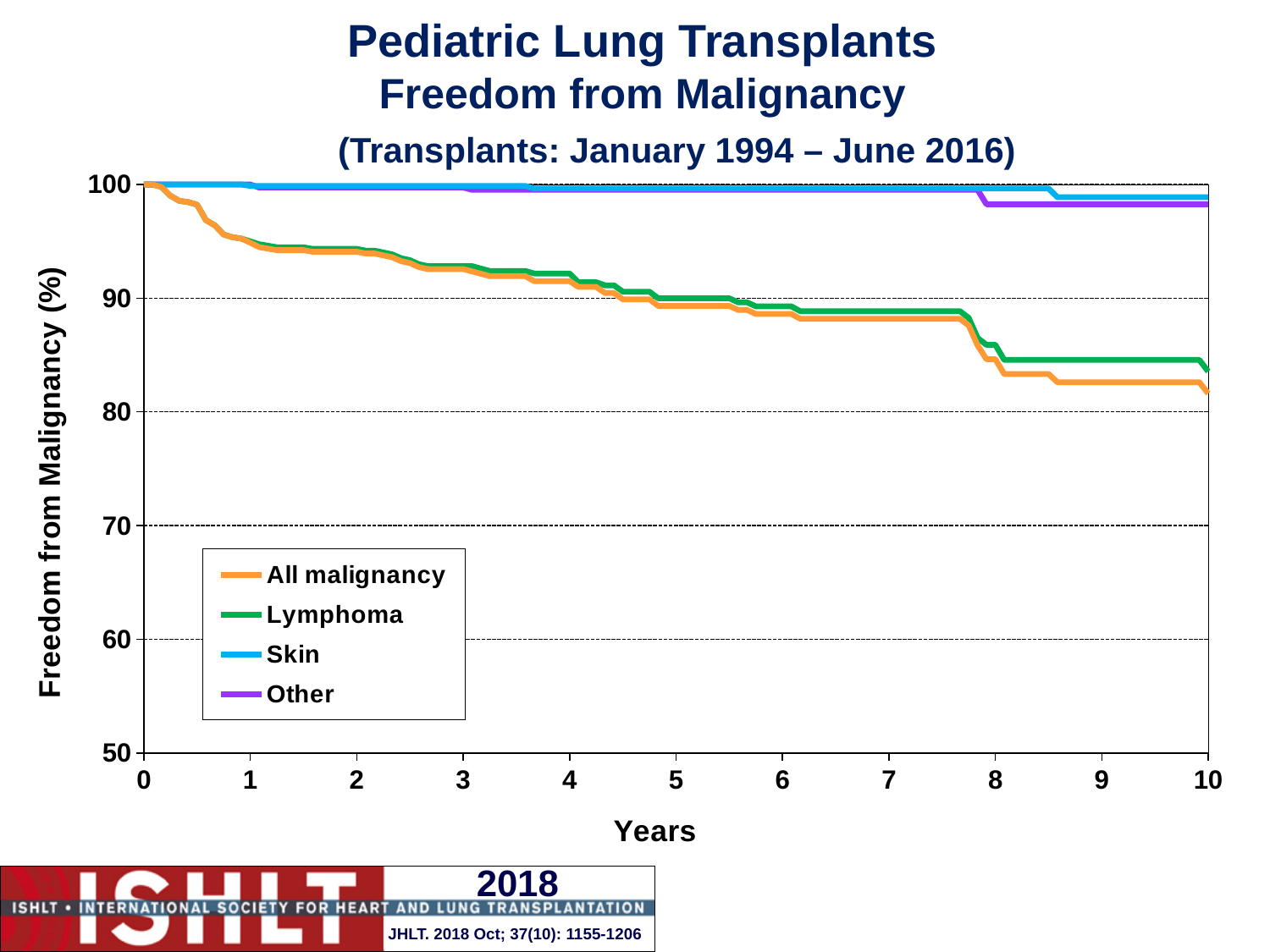
Is the value for All malignancy at 10 years greater or less than 80? greater What colour is the line for Skin? Light blue Is the value for Lymphoma at 2 years greater or less than 90? greater At 10 years, which is higher: Lymphoma or All malignancy? Lymphoma What kind of chart is shown on the slide? Line chart What is the label of the y axis? Freedom from Malignancy (%) Which series has the lowest freedom from malignancy at 10 years? All malignancy How many series does the legend list? 4 Do the values for All malignancy rise or fall as years increase? Fall Is the value for Other at 10 years greater or less than 90? greater Which series has the highest freedom from malignancy at 10 years? Skin